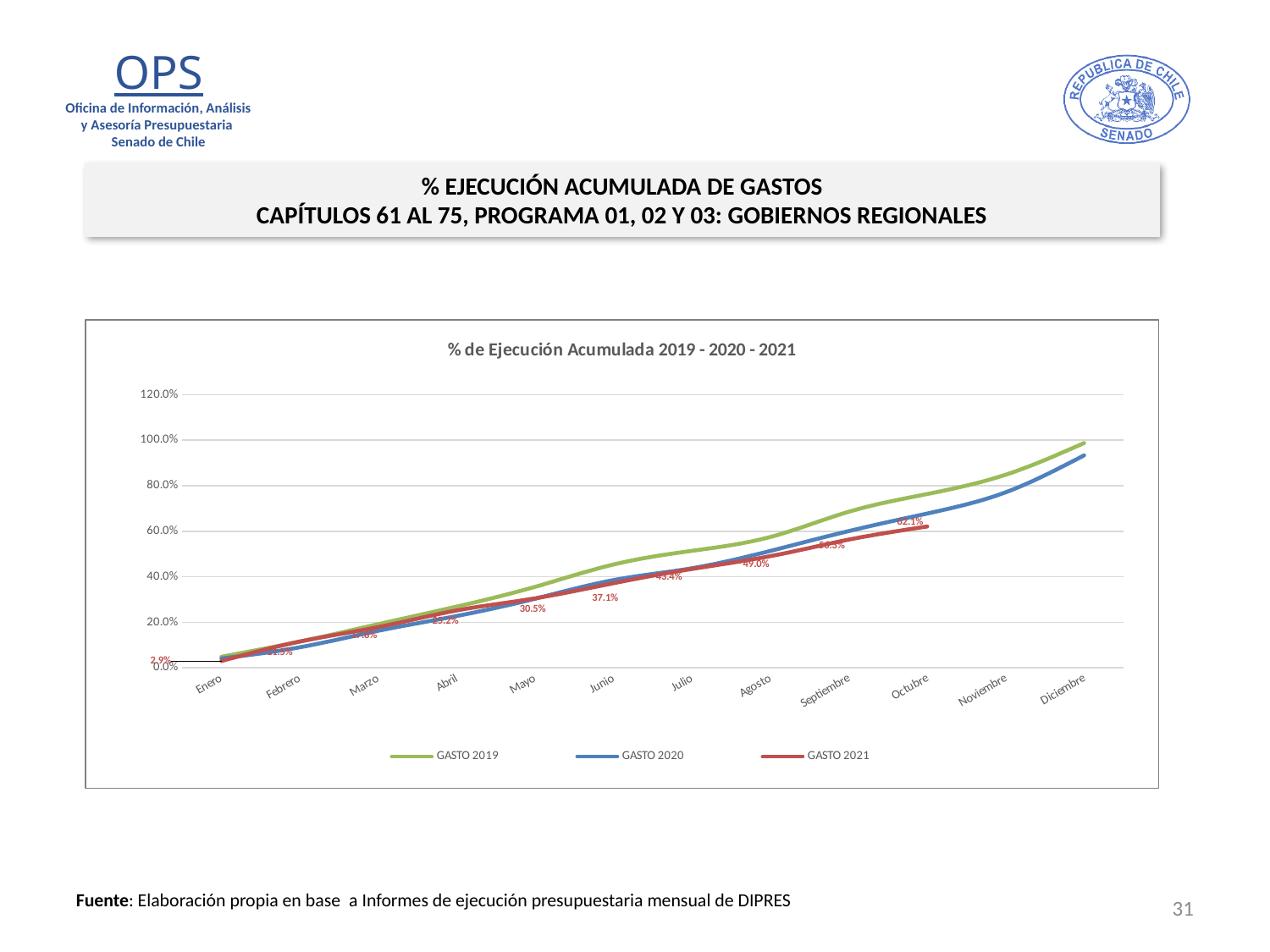
Which series has the higher value in Diciembre, GASTO 2019 or GASTO 2020? GASTO 2019 What kind of chart is shown on the slide? line chart What is the GASTO 2021 value for Junio? 37.1% What is the GASTO 2021 value for Agosto? 49.0% How many series does the chart legend list? 3 Is the GASTO 2019 value for Diciembre greater or less than 80.0%? greater What is the GASTO 2021 value for Enero? 2.9% How many months are shown along the x axis of the chart? 12 What is the GASTO 2021 value for Octubre? 62.1% Do the GASTO 2021 values rise or fall from Enero to Octubre? rise What is the GASTO 2021 value for Mayo? 30.5% What is the difference between the GASTO 2021 values for Octubre and Agosto? 13.1%